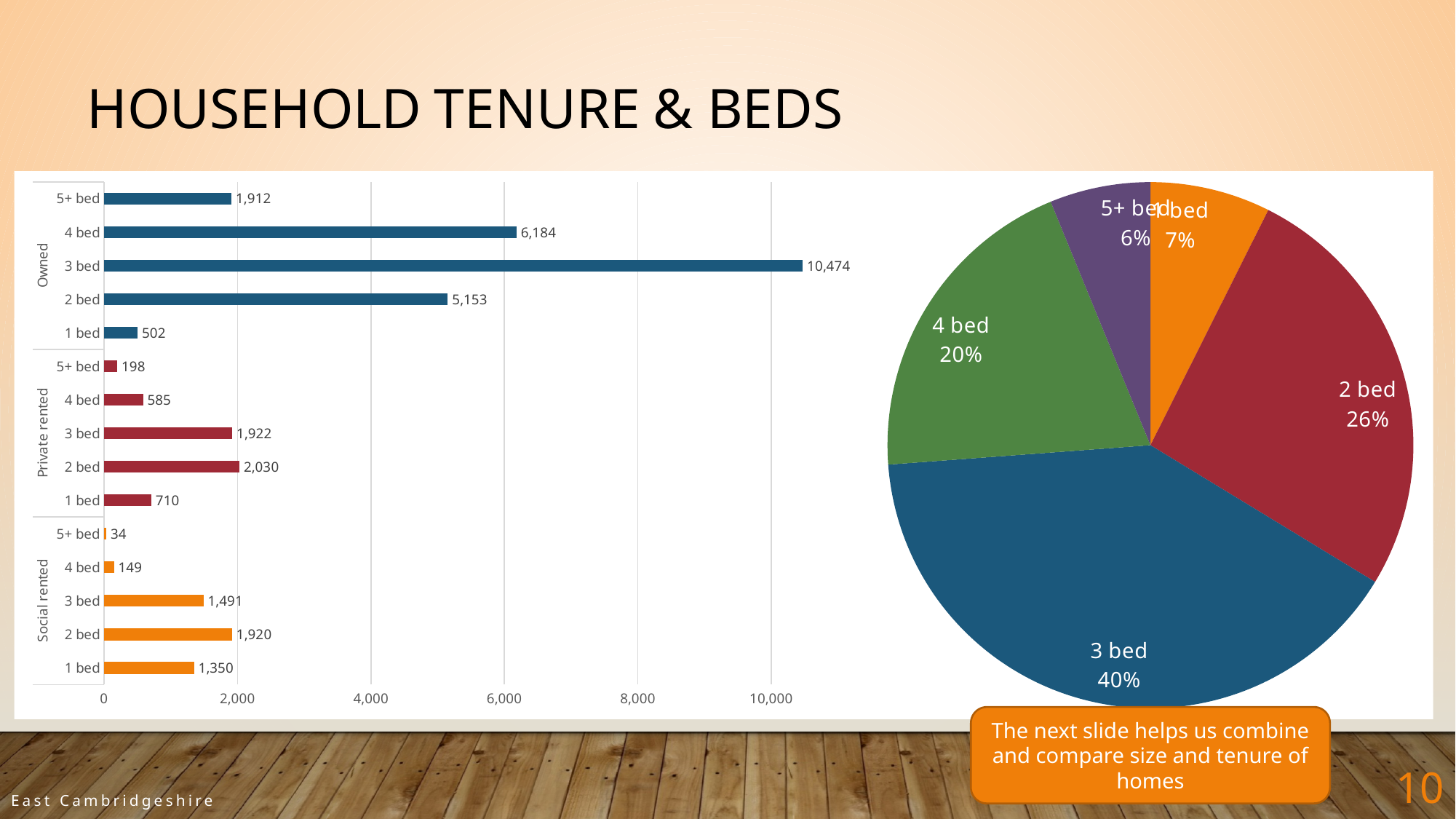
In the bar chart on the left, which bar has the lowest value? Social rented 5+ bed In the pie chart on the right, which bed size has the smallest share? 5+ bed In the bar chart on the left, what is the value for Private rented 1 bed? 710 In the pie chart on the right, how many slices are there? 5 In the pie chart on the right, what share do 3 bed homes have? 40% In the bar chart on the left, which is larger: Private rented 3 bed or Social rented 3 bed? Private rented 3 bed In the bar chart on the left, which bar has the highest value? Owned 3 bed In the bar chart on the left, how many bars are plotted in total? 15 What type of chart is shown on the left of the slide? Bar chart In the bar chart on the left, what is the difference between Owned 4 bed and Owned 2 bed? 1,031 In the bar chart on the left, what is the value for Social rented 2 bed? 1,920 In the bar chart on the left, how many Owned households have 3 beds? 10,474